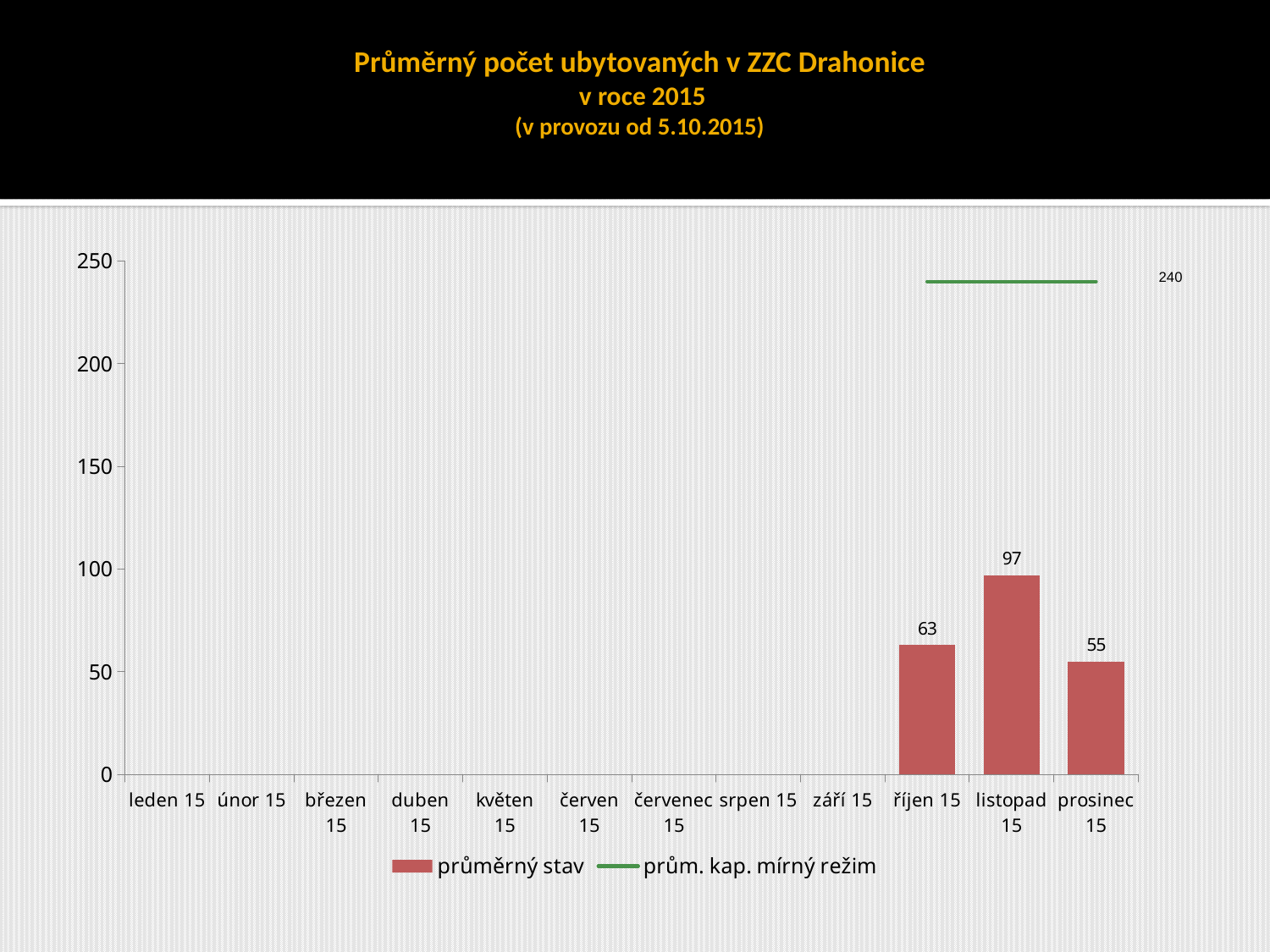
What is the value of průměrný stav for listopad 15? 97 What value is labelled on the prům. kap. mírný režim line? 240 What is the difference between the průměrný stav for listopad 15 and říjen 15? 34 How many months are shown on the x axis? 12 What is the value of průměrný stav for prosinec 15? 55 Which is larger, the průměrný stav for říjen 15 or prosinec 15? říjen 15 Among the months with bars, which has the lowest průměrný stav? prosinec 15 What is the title of the chart? Průměrný počet ubytovaných v ZZC Drahonice v roce 2015 (v provozu od 5.10.2015) Is the value for listopad 15 greater or less than 100? less How many series does the legend list? 2 What is the value of průměrný stav for říjen 15? 63 Which month has the highest průměrný stav? listopad 15